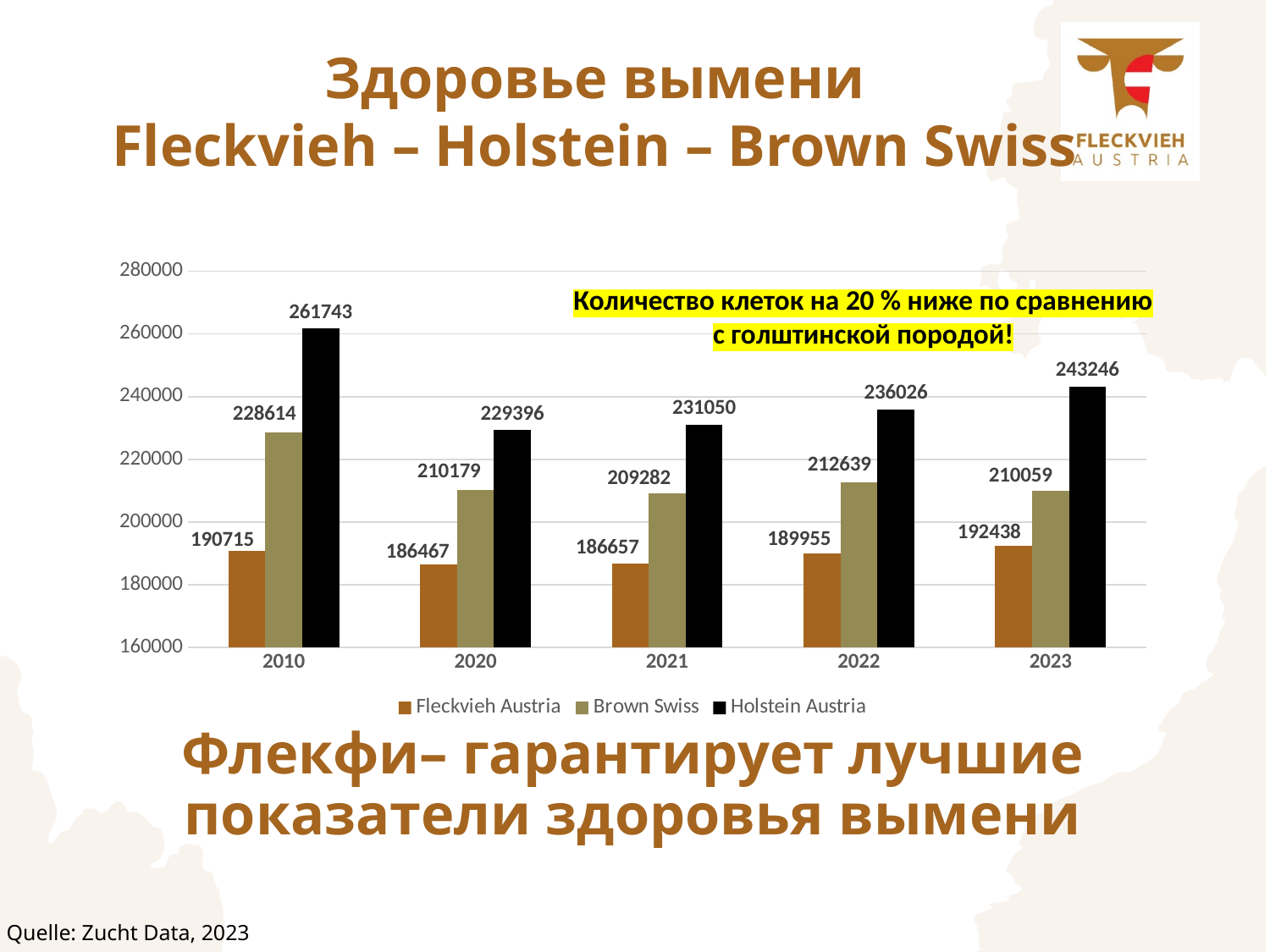
What is the value for Brown Swiss in 2021? 209282 What is the value for Holstein Austria in 2023? 243246 What colour represents Holstein Austria in the legend? black What is the value for Fleckvieh Austria in 2010? 190715 What is the difference between the Holstein Austria and Fleckvieh Austria values in 2023? 50808 What kind of chart is shown on the slide? bar chart In which year is the Holstein Austria value highest? 2010 How many years are shown on the x axis? 5 Which year has the larger Brown Swiss value, 2022 or 2023? 2022 Is the value for Fleckvieh Austria in 2023 greater or less than 200000? less How many series does the legend list? 3 In which year is the Fleckvieh Austria value lowest? 2020